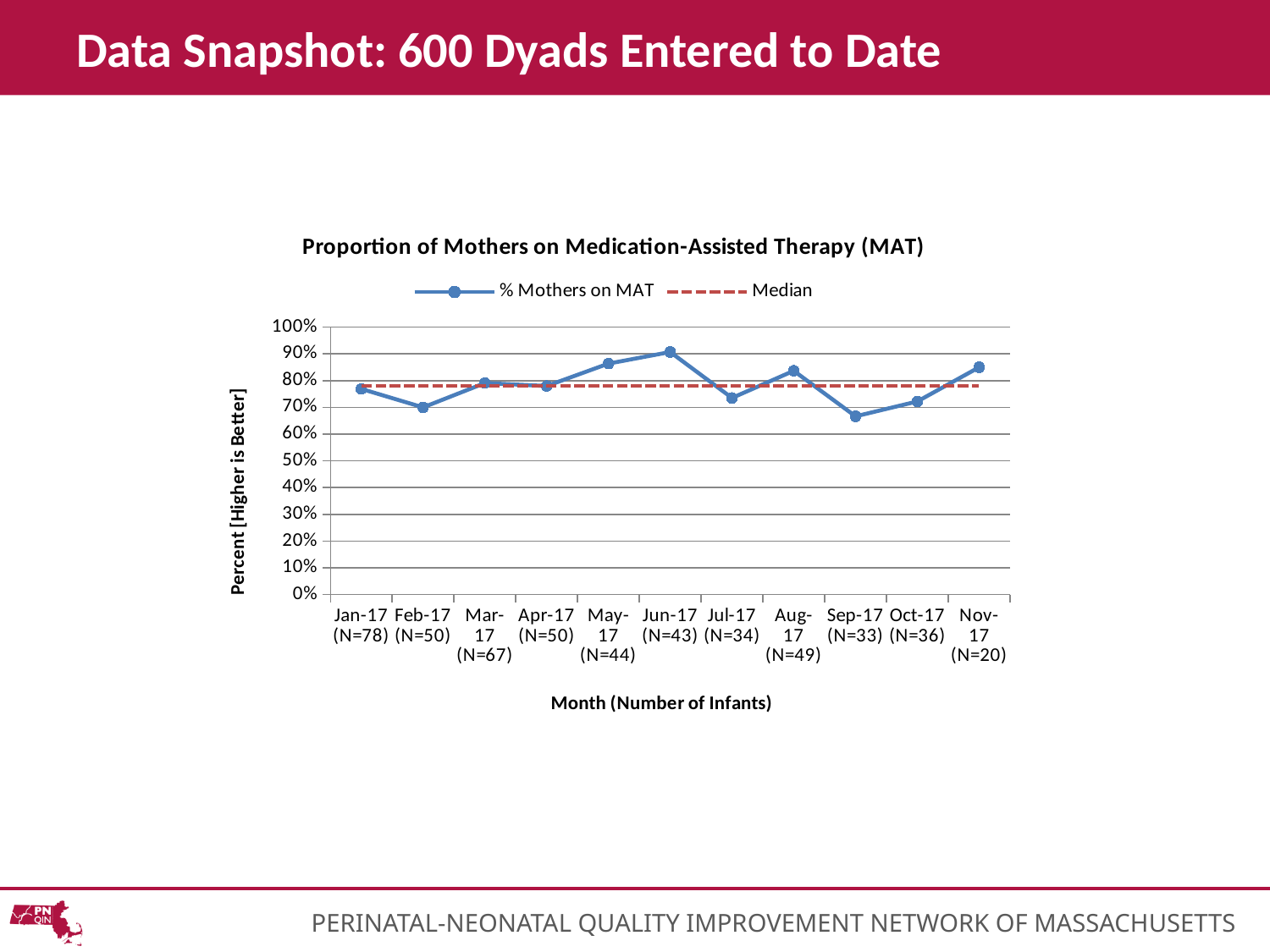
Is the % Mothers on MAT for Jun-17 greater or less than 80%? greater What kind of chart is shown on the slide? line chart Which is larger, the % Mothers on MAT for Jun-17 or for Jul-17? Jun-17 Is the % Mothers on MAT for Sep-17 greater or less than 80%? less Is the % Mothers on MAT for May-17 greater or less than 80%? greater What is the label of the y axis? Percent [Higher is Better] How many months are plotted on the x axis? 11 Which is larger, the % Mothers on MAT for Aug-17 or for Sep-17? Aug-17 What is the title of the chart? Proportion of Mothers on Medication-Assisted Therapy (MAT) How many series does the legend list? 2 Which month has the lowest % Mothers on MAT? Sep-17 Which month has the highest % Mothers on MAT? Jun-17